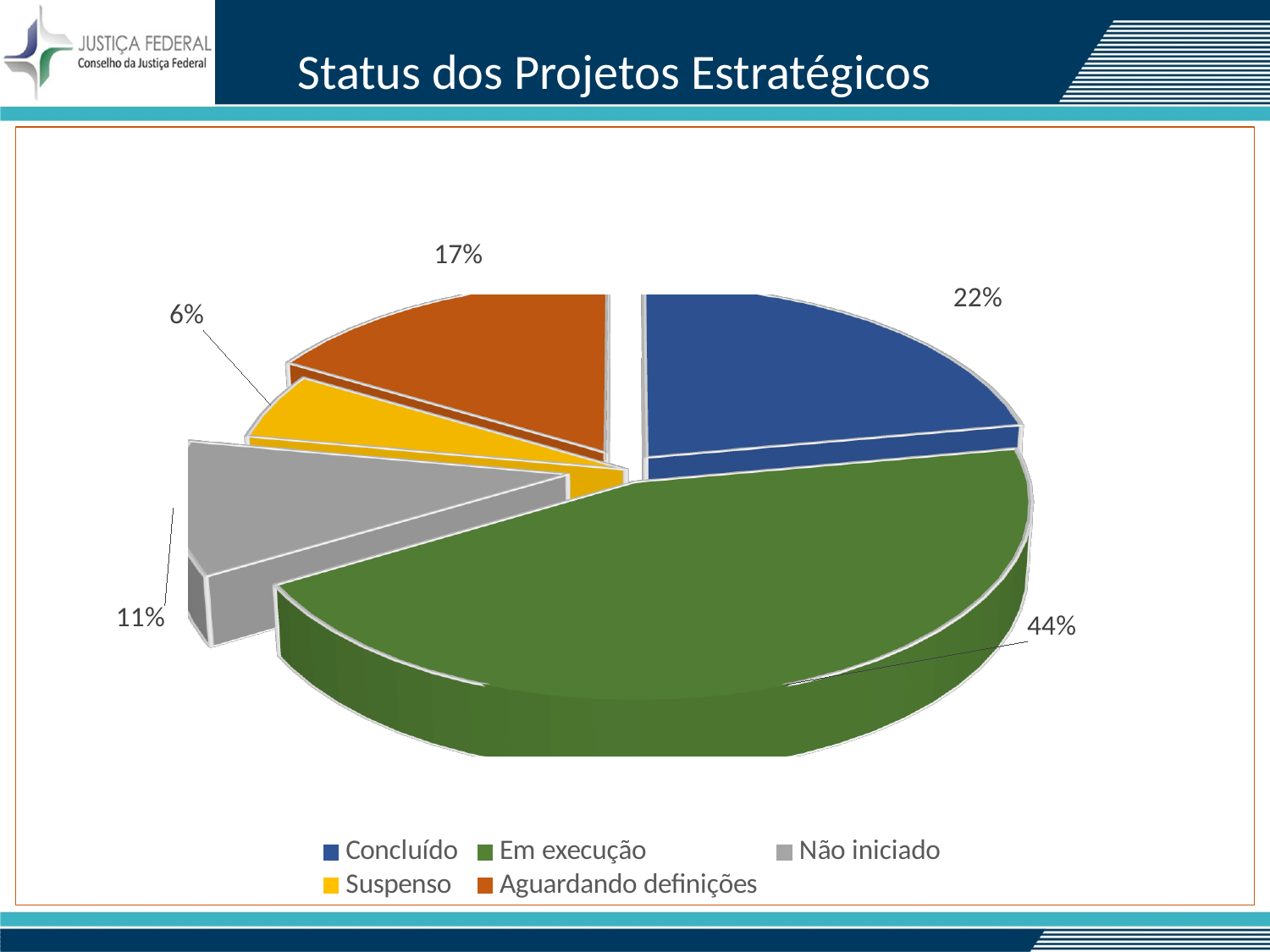
Which category has the smallest slice of the pie? Suspenso Which is larger, the share for Aguardando definições or the share for Não iniciado? Aguardando definições What is the difference in percentage points between Em execução and Concluído? 22 What kind of chart is shown on the slide? pie chart What share of the pie is labelled for Em execução? 44% How many categories does the legend list? 5 What share of the pie is labelled for Suspenso? 6% What is the title of the slide containing the chart? Status dos Projetos Estratégicos Which category has the largest slice of the pie? Em execução What share of the pie is labelled for Aguardando definições? 17%